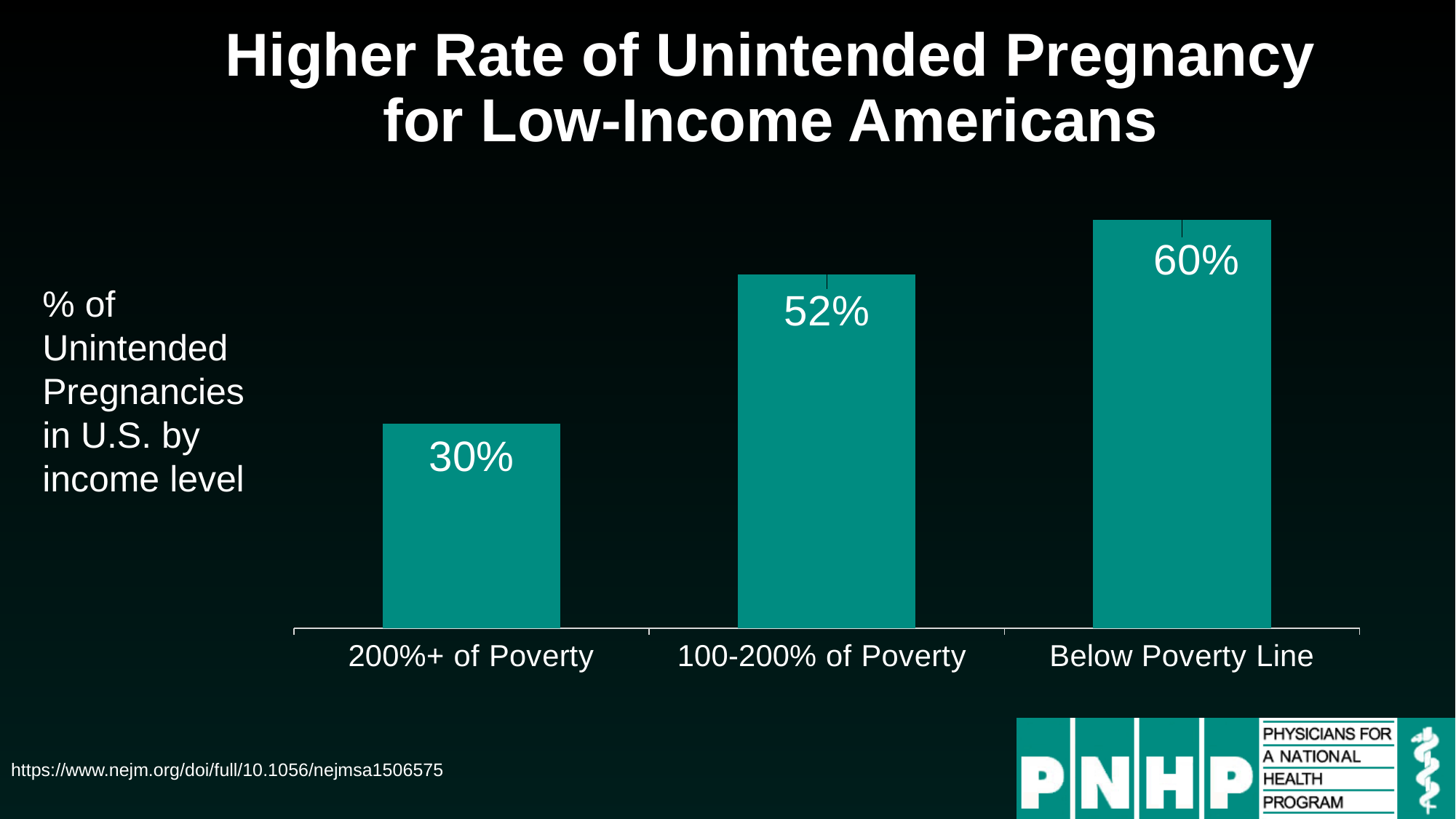
What kind of chart is shown on the slide? Bar chart Which income group has the lowest rate of unintended pregnancies? 200%+ of Poverty How many income groups are shown in the chart? 3 Which income group has the highest rate of unintended pregnancies? Below Poverty Line What is the title of the slide? Higher Rate of Unintended Pregnancy for Low-Income Americans What is the percentage of unintended pregnancies for the 100-200% of Poverty group? 52% What is the percentage of unintended pregnancies for the 200%+ of Poverty group? 30% What is the difference in percentage points between the 100-200% of Poverty group and the 200%+ of Poverty group? 22 What is the percentage of unintended pregnancies for the Below Poverty Line group? 60% What is the difference in percentage points between the Below Poverty Line group and the 200%+ of Poverty group? 30 Which has a higher rate of unintended pregnancies: 100-200% of Poverty or Below Poverty Line? Below Poverty Line Do the values rise or fall moving from left to right across the income groups? Rise